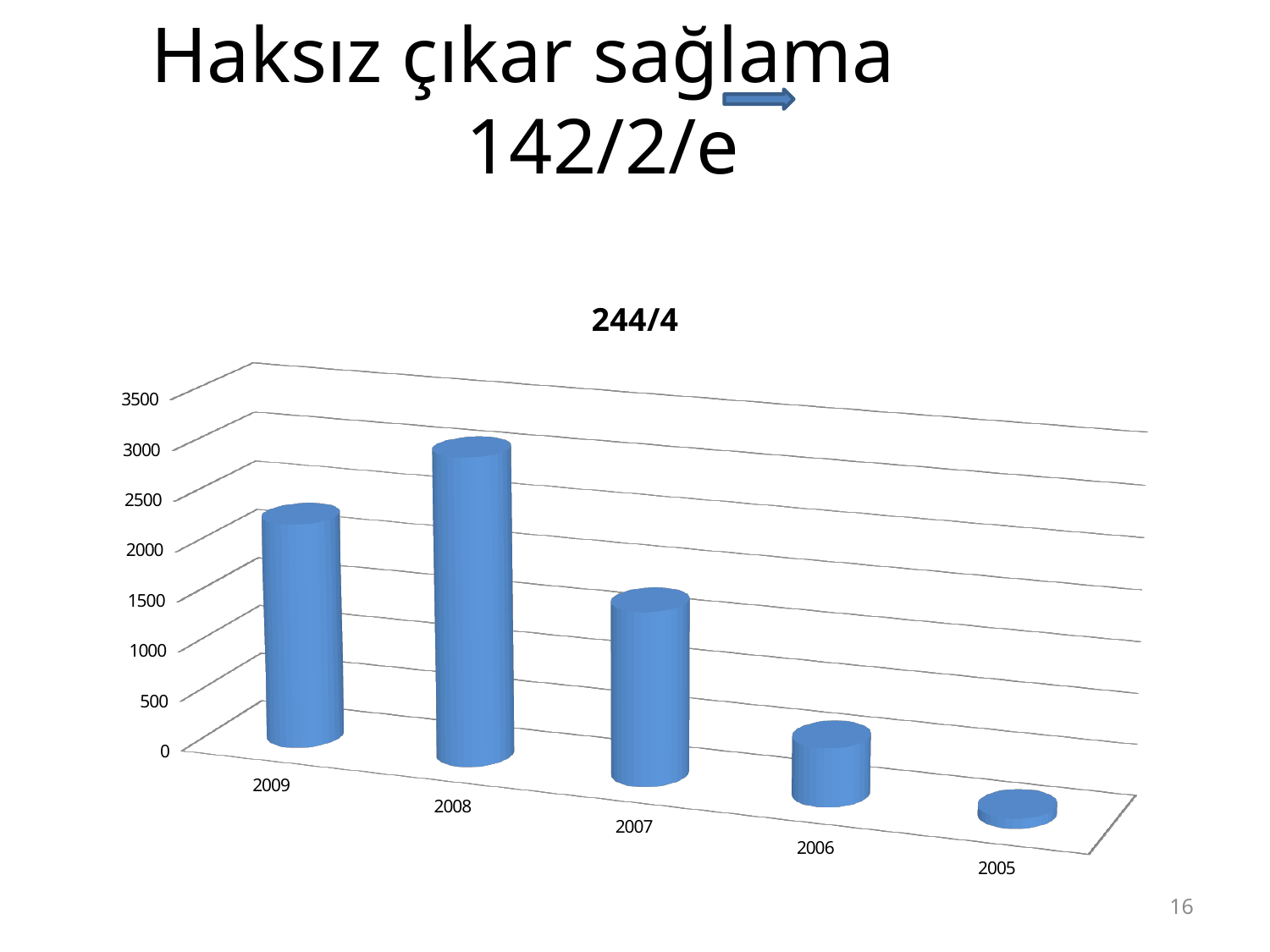
Is the value for 2008 greater or less than 2500? greater Which is larger, the value for 2006 or the value for 2005? 2006 Is the value for 2006 greater or less than 1000? less Is the value for 2005 greater or less than 500? less Which is larger, the value for 2009 or the value for 2007? 2009 Which year has the lowest bar in the chart? 2005 What kind of chart is shown on the slide? bar chart How many years are shown on the x axis of the chart? 5 Which year has the highest bar in the chart? 2008 Moving along the x axis from 2008 to 2005, do the values rise or fall? fall What is the title of the chart? 244/4